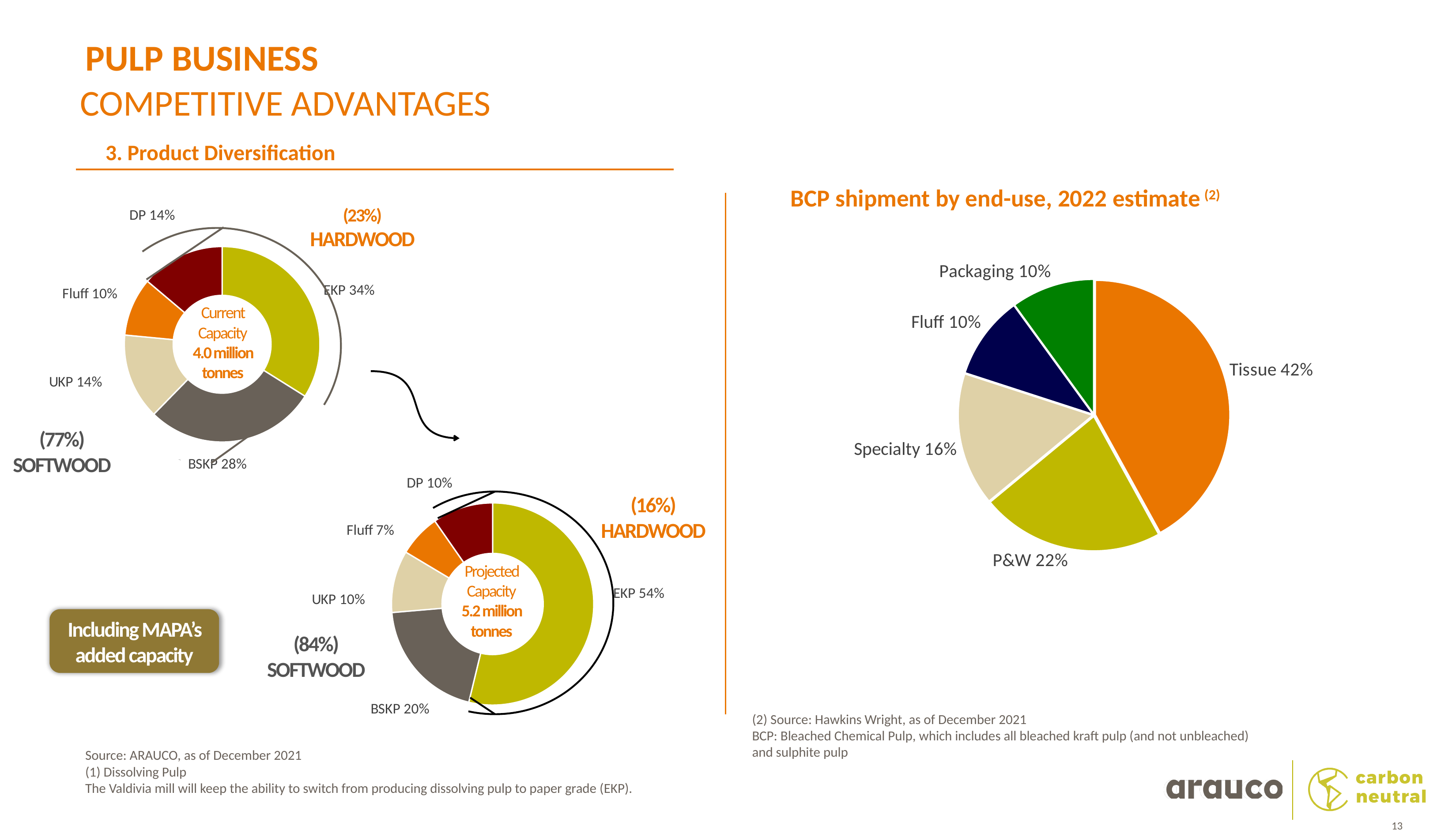
In the Current Capacity chart, which category has the largest share? EKP In the BCP shipment by end-use chart, what share is Tissue? 42% In the Current Capacity chart, which category has the smallest share? Fluff In the Current Capacity chart, what is the difference between the EKP share and the BSKP share? 6 percentage points In the Current Capacity chart, what share is EKP? 34% In the Projected Capacity chart, what share is Fluff? 7% In the Projected Capacity chart, which is larger, BSKP or UKP? BSKP What kind of chart is the BCP shipment by end-use chart? Pie chart How many categories does the Projected Capacity chart show? 5 In the BCP shipment by end-use chart, what is the difference between the Tissue share and the P&W share? 20 percentage points What total capacity is shown in the centre of the Current Capacity chart? 4.0 million tonnes In the Projected Capacity chart, what share is EKP? 54%